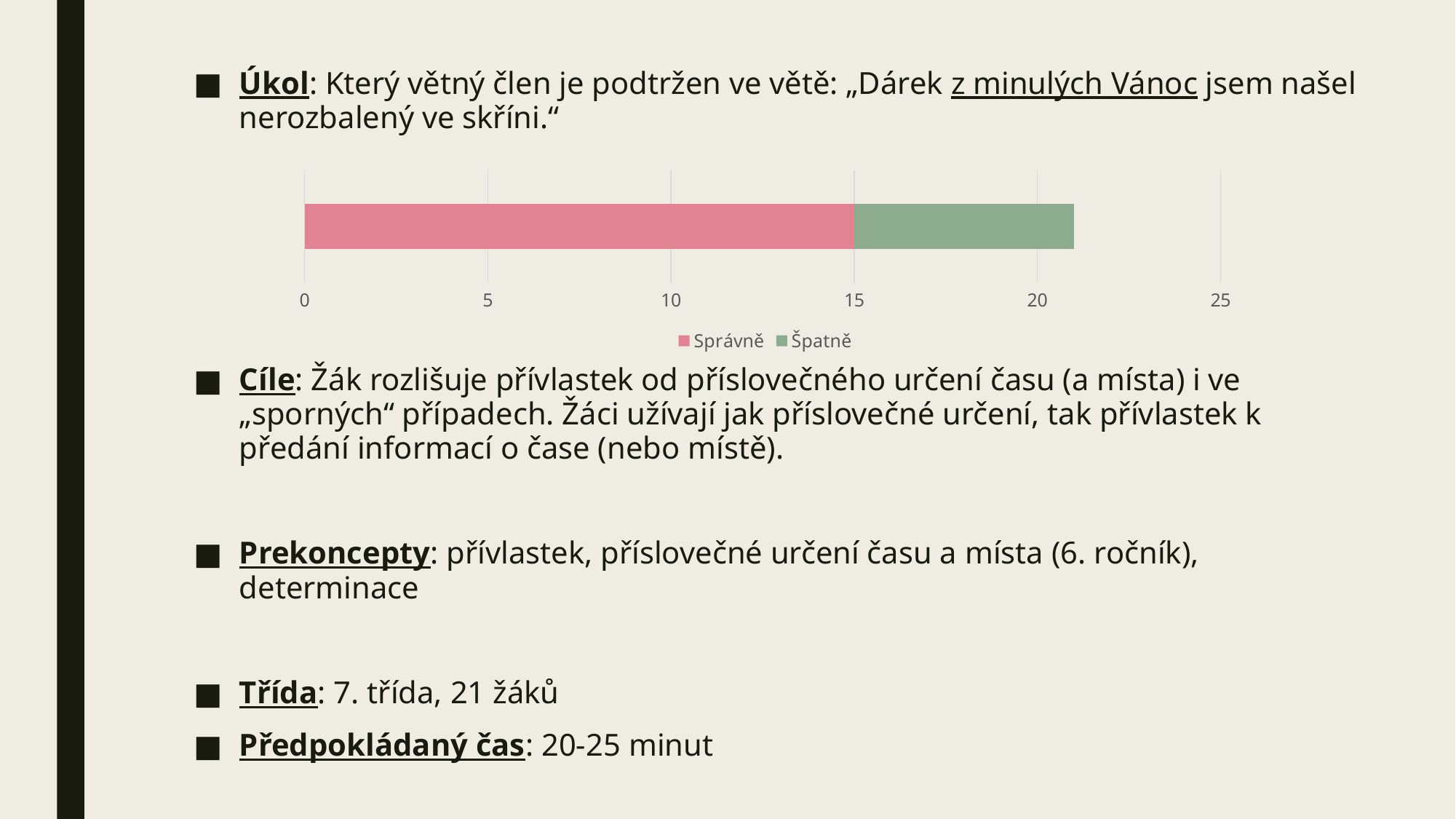
Is the total length of the stacked bar greater or less than 20? greater Is the value for Správně greater or less than 10? greater What colour is the Správně series in the chart? pink What is the value of the Správně segment of the bar? 15 How many stacked bars does the chart contain? 1 Which series has the larger value, Správně or Špatně? Správně Is the value for Špatně greater or less than 10? less What is the highest value shown on the chart's axis? 25 What kind of chart is shown on the slide? bar chart What are the two series named in the chart legend? Správně and Špatně Which series has the smaller segment in the bar? Špatně How many series does the chart legend list? 2